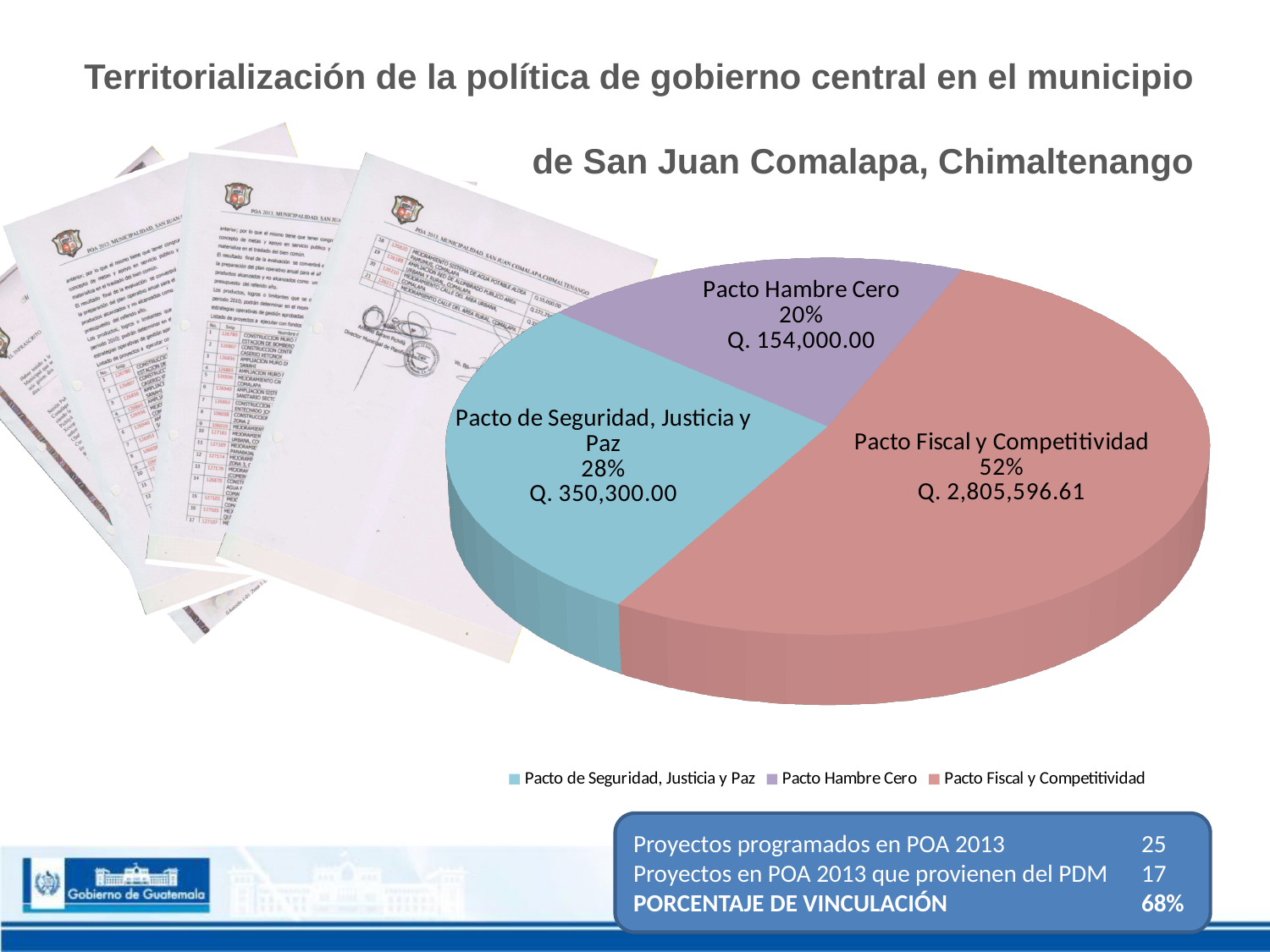
What amount is shown for Pacto Hambre Cero in the pie chart? Q. 154,000.00 What amount is shown for Pacto de Seguridad, Justicia y Paz in the pie chart? Q. 350,300.00 What percentage share does Pacto de Seguridad, Justicia y Paz have in the pie chart? 28% How many entries does the legend of the pie chart list? 3 Which slice of the pie chart is the largest? Pacto Fiscal y Competitividad What percentage share does Pacto Hambre Cero have in the pie chart? 20% What is the difference in percentage points between the shares of Pacto de Seguridad, Justicia y Paz and Pacto Hambre Cero? 8 percentage points Which slice of the pie chart is the smallest? Pacto Hambre Cero What kind of chart is shown on the slide? Pie chart What percentage share does Pacto Fiscal y Competitividad have in the pie chart? 52% What amount is shown for Pacto Fiscal y Competitividad in the pie chart? Q. 2,805,596.61 How many slices does the pie chart have? 3